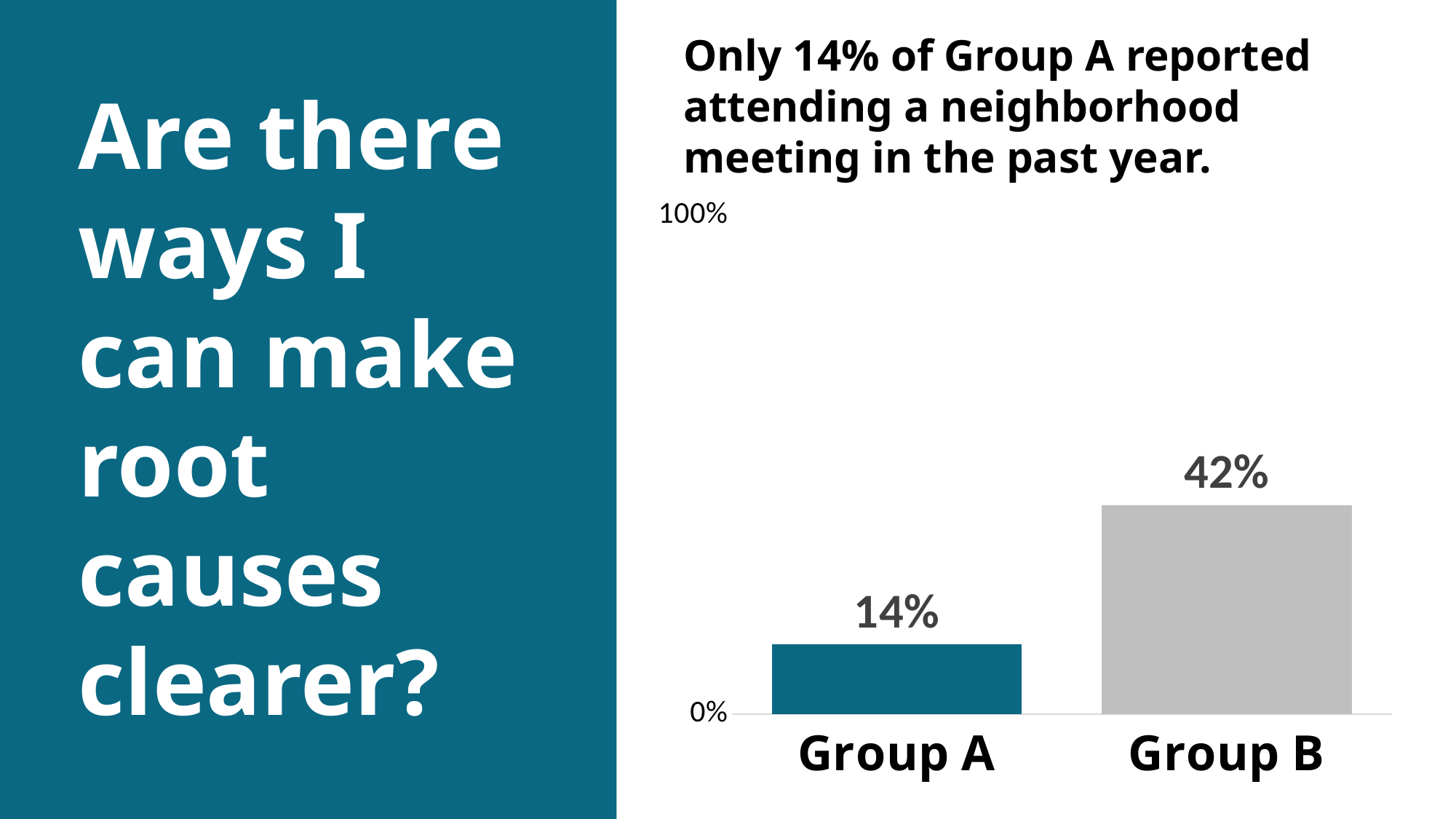
Do the values rise or fall from Group A to Group B? rise What is the value for Group A? 14% What kind of chart is shown on the slide? bar chart What colour is the bar for Group A? teal Which group has the highest value? Group B Which group has the lowest value? Group A Which is larger, the value for Group A or the value for Group B? Group B What is the title of the chart? Only 14% of Group A reported attending a neighborhood meeting in the past year. Is the value for Group B greater or less than 100%? less What is the difference between the values for Group B and Group A? 28% What is the value for Group B? 42% How many categories are shown in the chart? 2